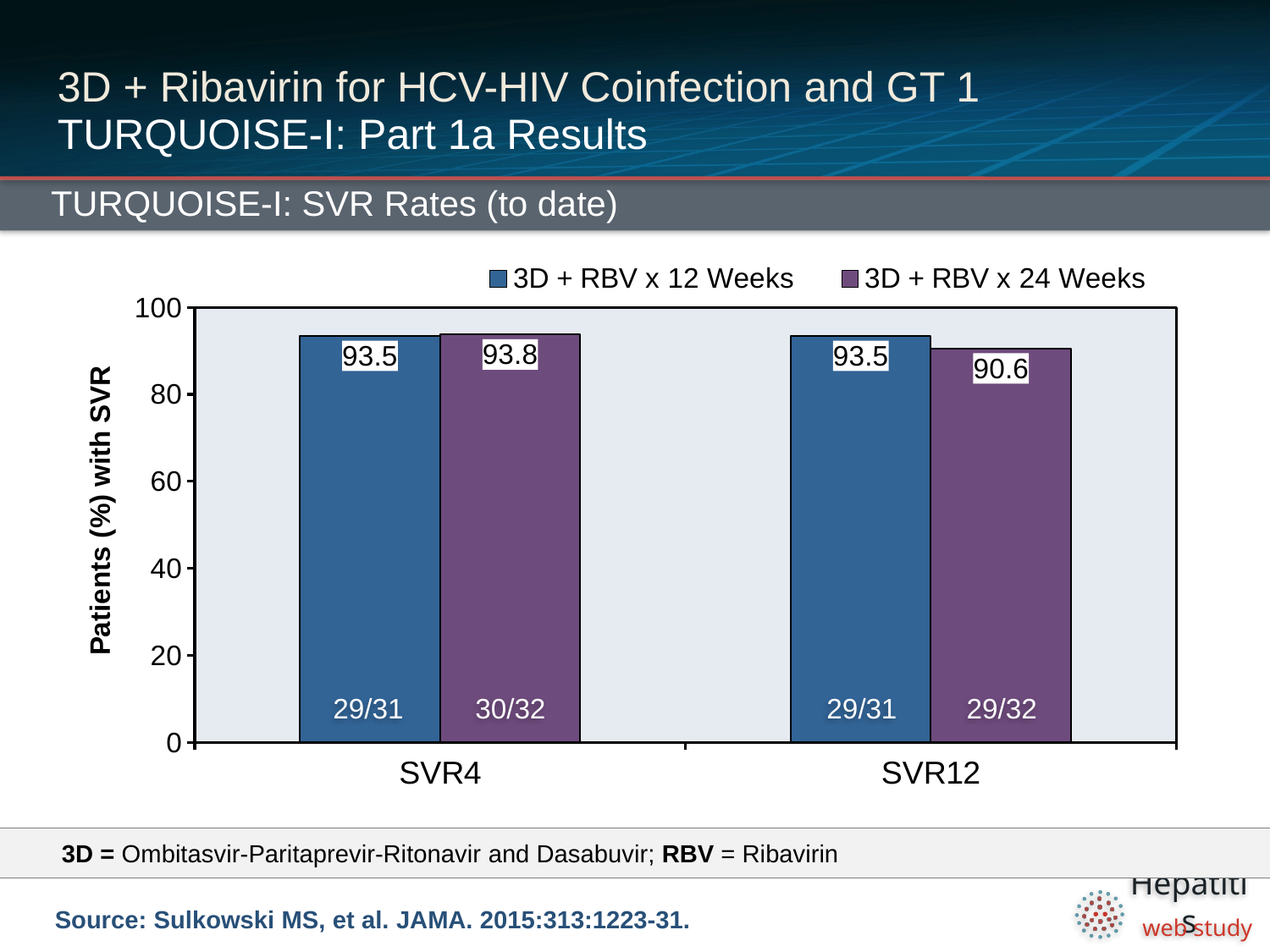
At SVR12, which group has the higher rate: 3D + RBV x 12 Weeks or 3D + RBV x 24 Weeks? 3D + RBV x 12 Weeks Is the SVR12 rate for the 3D + RBV x 24 Weeks group greater or less than 80? greater What is the SVR12 rate for the 3D + RBV x 24 Weeks group? 90.6 What is the difference between the SVR4 and SVR12 rates for the 3D + RBV x 24 Weeks group? 3.2 What is the label of the y axis? Patients (%) with SVR How many series does the legend list? 2 Which bar shows the lowest SVR rate on the chart? 3D + RBV x 24 Weeks at SVR12 What is the SVR4 rate for the 3D + RBV x 12 Weeks group? 93.5 What kind of chart is shown on the slide? Bar chart How many categories are shown on the x axis? 2 How many patients achieved SVR12 in the 3D + RBV x 24 Weeks group, as shown at the base of the bar? 29/32 What is the SVR4 rate for the 3D + RBV x 24 Weeks group? 93.8